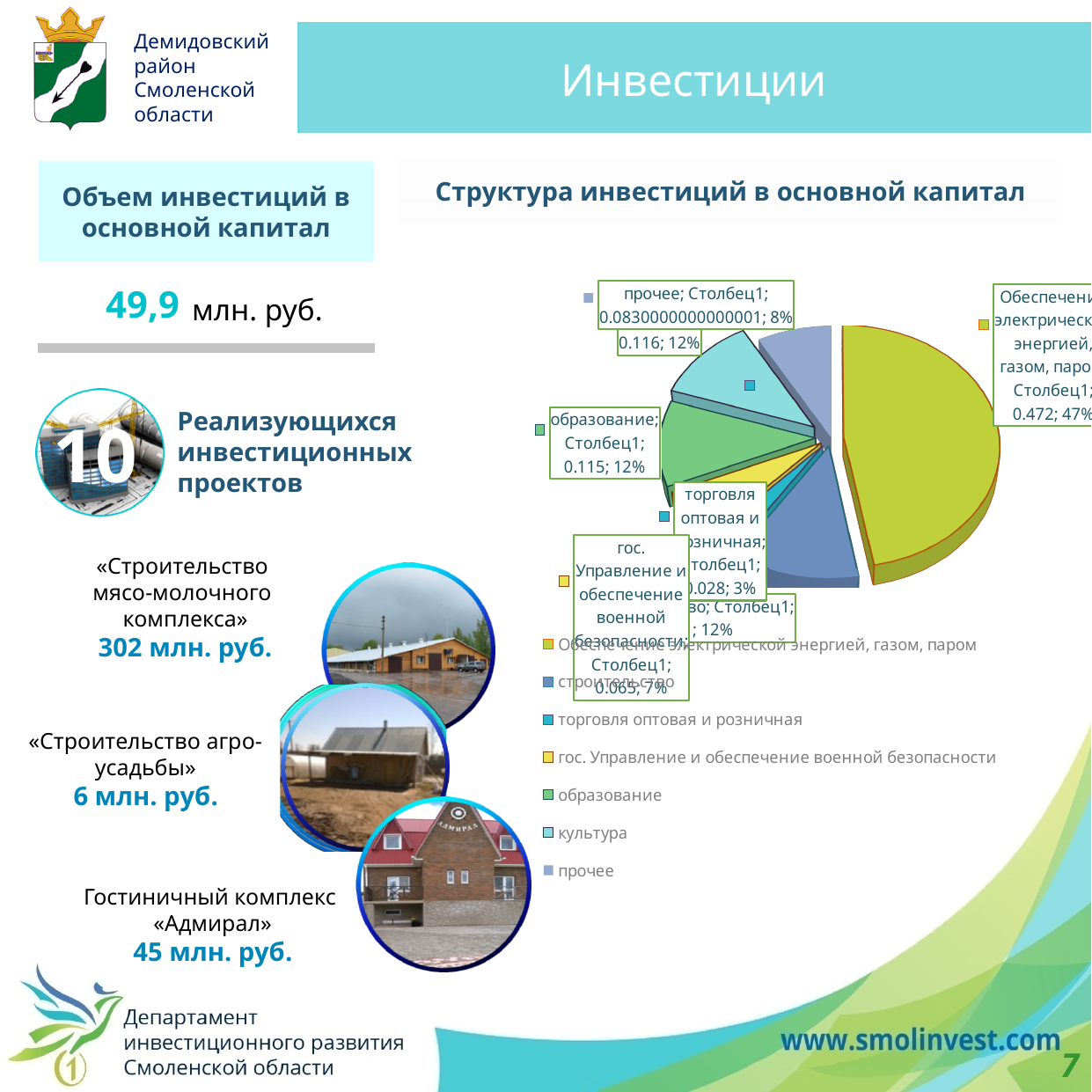
By how many percentage points does the share of "Обеспечение электрической энергией, газом, паром" exceed that of "торговля оптовая и розничная"? 44 What share of the pie does "образование" have? 12% What share of the pie does "прочее" have? 8% What share of the pie does "Обеспечение электрической энергией, газом, паром" have? 47% What value is printed for "торговля оптовая и розничная" in the pie chart's data label? 0.028 What kind of chart is shown under the title "Структура инвестиций в основной капитал"? pie chart What is the title of the pie chart on the slide? Структура инвестиций в основной капитал Which category has the smallest slice of the pie chart? торговля оптовая и розничная Which slice is larger: "образование" or "прочее"? образование How many categories does the legend of the pie chart list? 7 Which category has the largest slice of the pie chart? Обеспечение электрической энергией, газом, паром